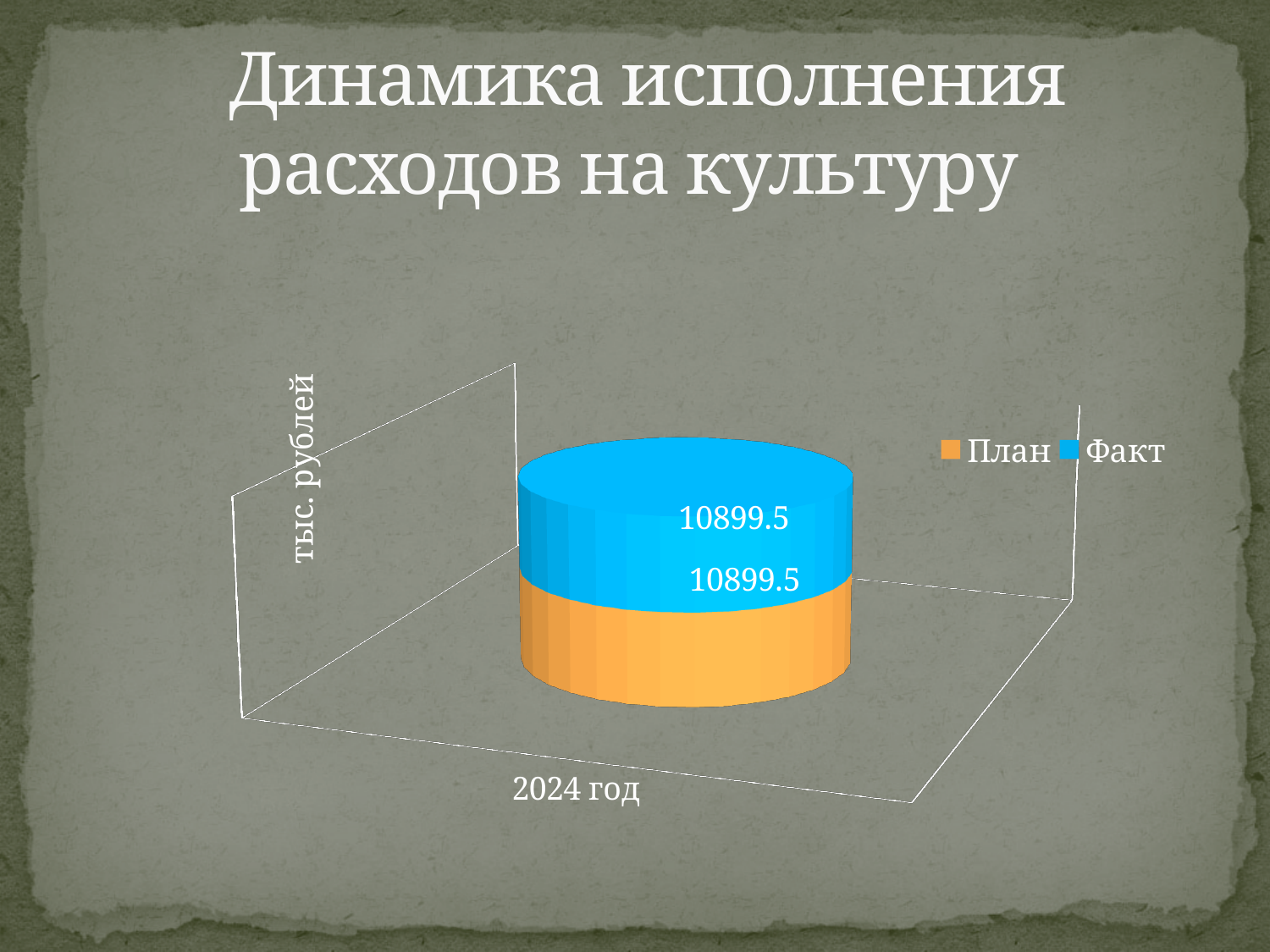
What is the label of the vertical axis? тыс. рублей How many series does the legend list? 2 What is the total of the stacked bar for 2024 год? 21799 Which category label appears on the x axis? 2024 год What is the difference between the Факт and План values for 2024 год? 0 What kind of chart is shown on the slide? Bar chart What is the value for План in 2024 год? 10899.5 How many categories are shown on the x axis? 1 What is the value for Факт in 2024 год? 10899.5